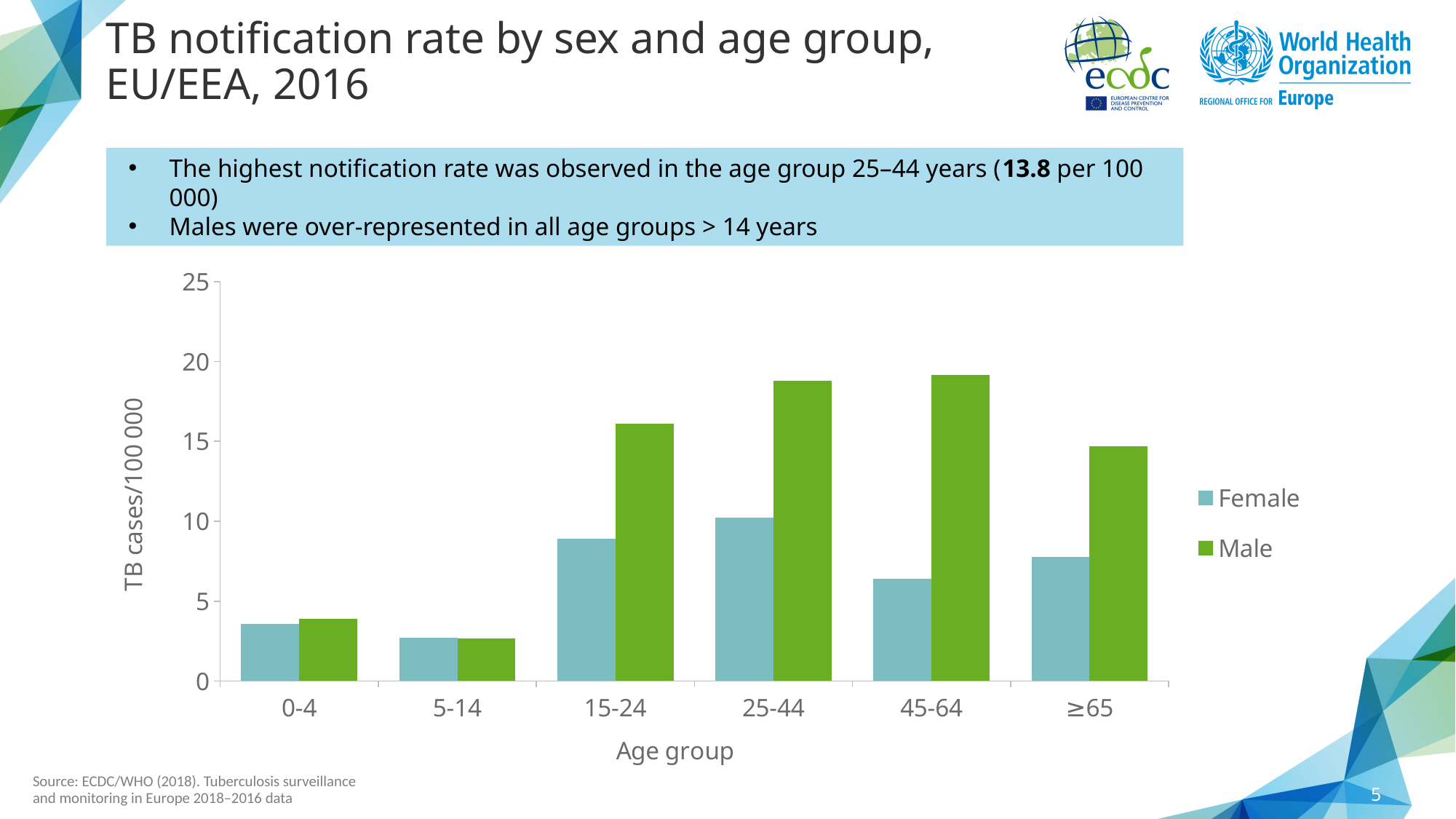
How many series does the chart's legend list? 2 In the 15-24 age group, which is larger, the Female or the Male value? Male Is the Male value for the 15-24 age group greater or less than 15? greater What kind of chart is shown on the slide? bar chart How many age groups are shown on the x axis of the chart? 6 Which age group has the lowest Male notification rate? 5-14 Which age group has the highest Female notification rate? 25-44 Which age group has the lowest Female notification rate? 5-14 Is the Male value for the 25-44 age group greater or less than 20? less What is the label of the y axis of the chart? TB cases/100 000